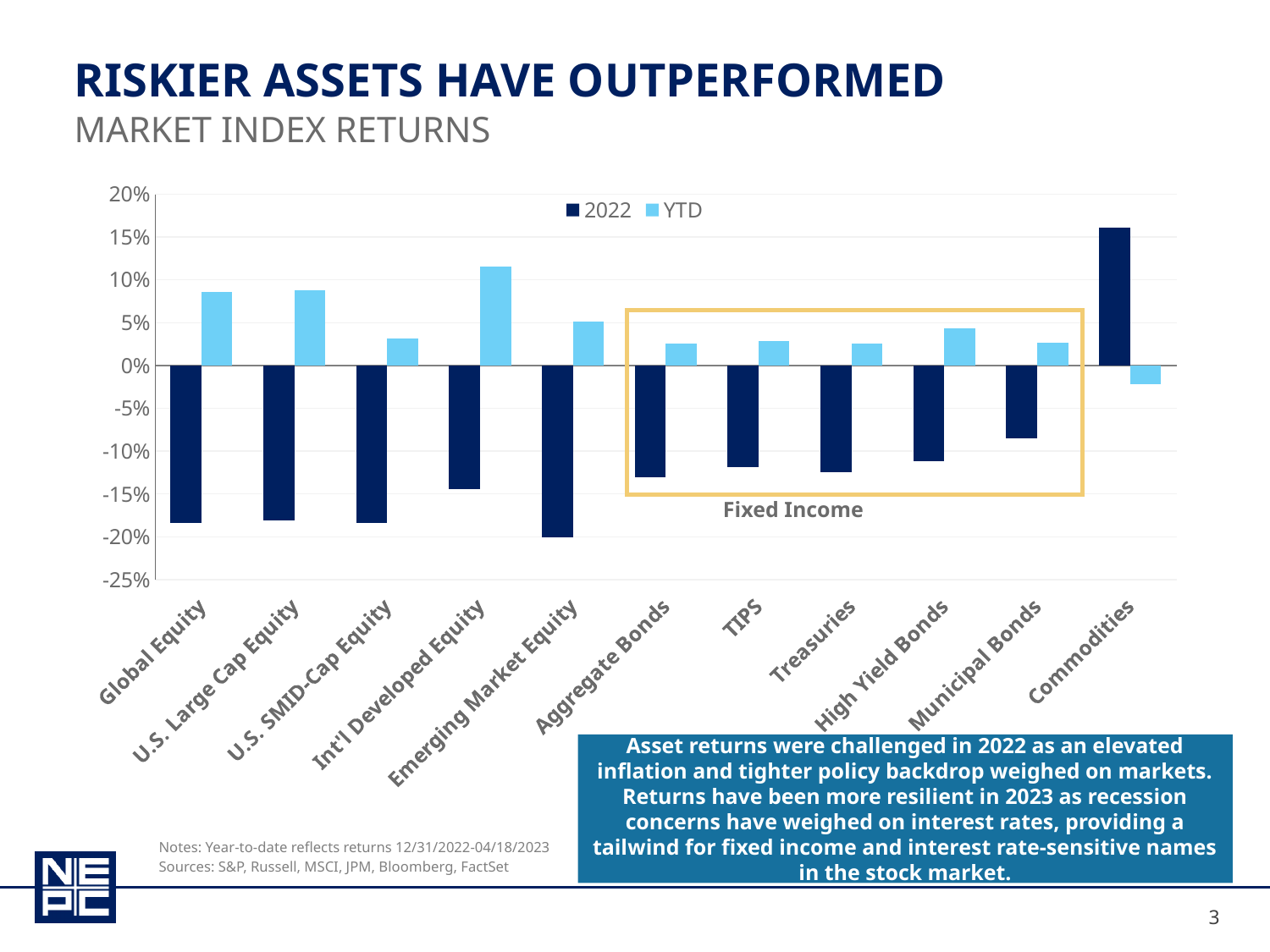
Is the 2022 value for Municipal Bonds greater or less than -10%? greater How many series does the legend list? 2 Which category has the lowest 2022 return? Emerging Market Equity Is the 2022 value for Emerging Market Equity greater or less than -15%? less Which category has the lowest YTD return? Commodities Is the 2022 value for Commodities greater or less than 10%? greater What kind of chart is shown on the slide? Bar chart Which category has the highest YTD return? Int'l Developed Equity Which category has the highest 2022 return? Commodities Which categories are enclosed by the box labelled 'Fixed Income'? Aggregate Bonds, TIPS, Treasuries, High Yield Bonds, Municipal Bonds Which is larger, the YTD return for Int'l Developed Equity or the YTD return for Global Equity? Int'l Developed Equity How many asset categories are shown on the x axis? 11